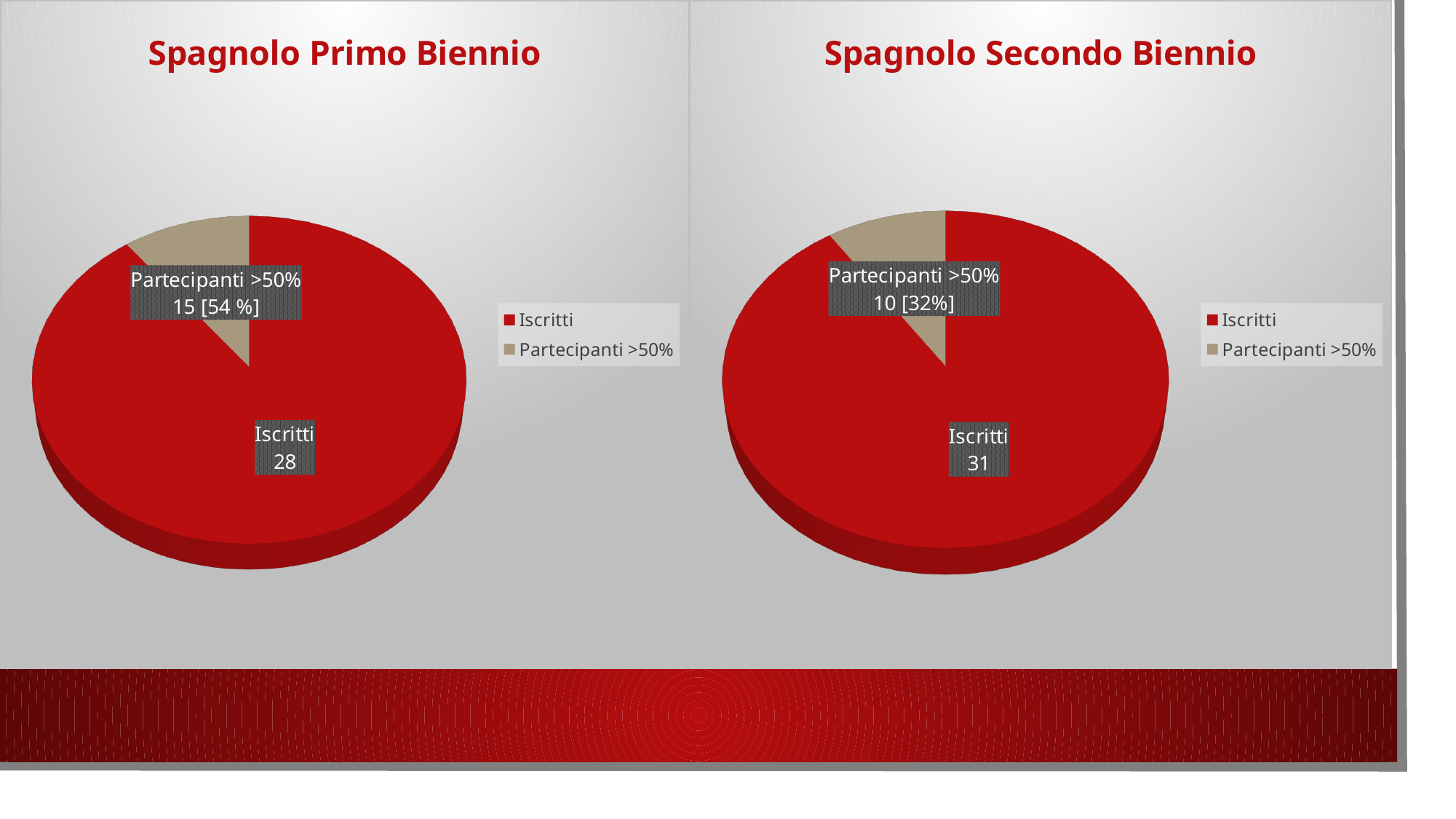
What kind of chart is the Spagnolo Primo Biennio chart? Pie chart In the Spagnolo Secondo Biennio chart, what is the value for Iscritti? 31 In the Spagnolo Secondo Biennio chart, which category has the smallest slice? Partecipanti >50% How many entries does the legend of the Spagnolo Secondo Biennio chart list? 2 In the Spagnolo Primo Biennio chart, what is the difference between the Iscritti value and the Partecipanti >50% count? 13 In the Spagnolo Primo Biennio chart, what is the value shown for Partecipanti >50%? 15 [54 %] In the Spagnolo Primo Biennio chart, what colour is the Iscritti slice? Red Which chart has the higher Iscritti value, Spagnolo Primo Biennio or Spagnolo Secondo Biennio? Spagnolo Secondo Biennio In the Spagnolo Primo Biennio chart, which category has the largest slice? Iscritti In the Spagnolo Secondo Biennio chart, what is the difference between the Iscritti value and the Partecipanti >50% count? 21 In the Spagnolo Secondo Biennio chart, what is the value shown for Partecipanti >50%? 10 [32%] In the Spagnolo Primo Biennio chart, what is the value for Iscritti? 28